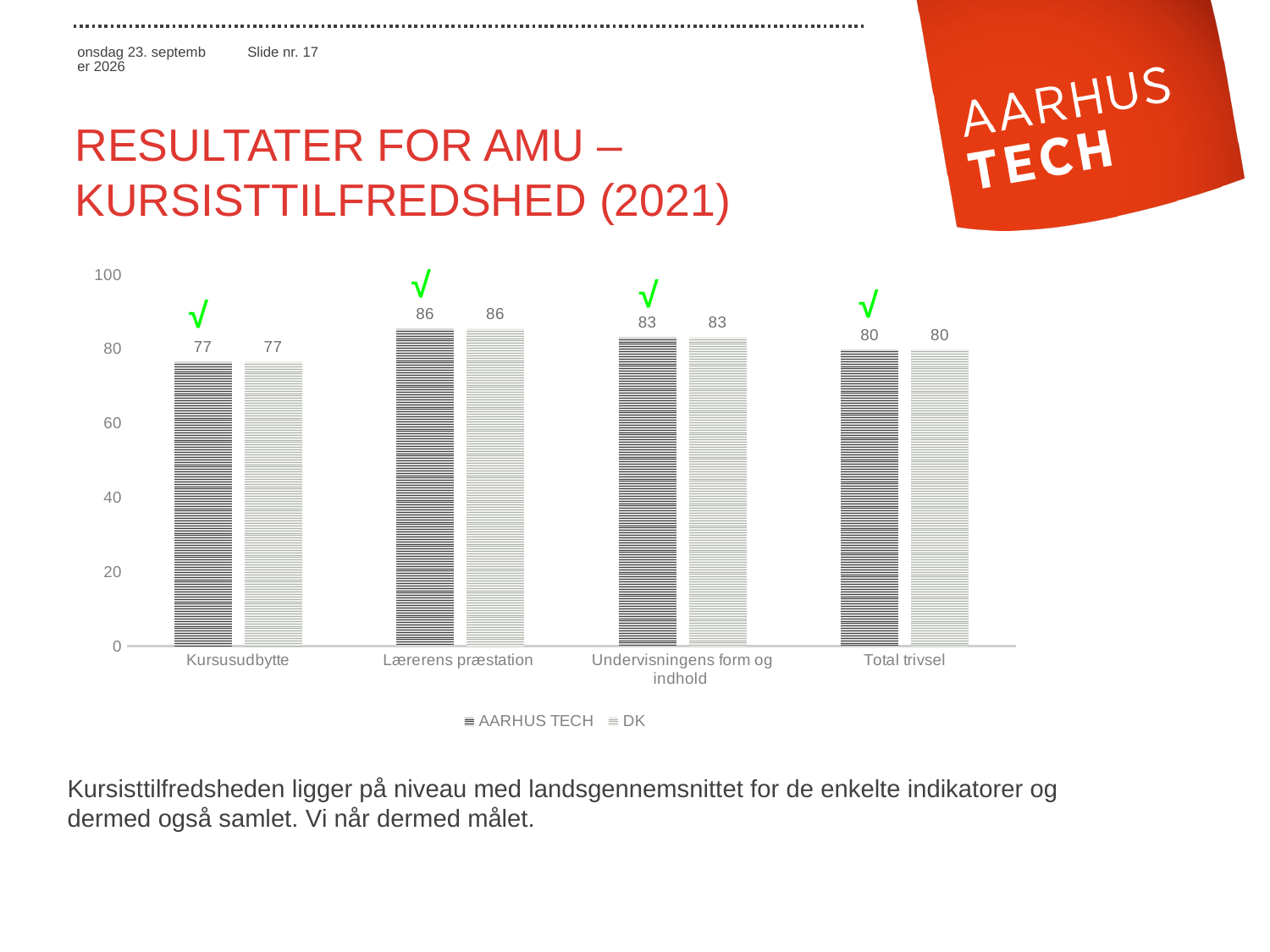
How many categories are shown on the x axis? 4 What is the AARHUS TECH value for Undervisningens form og indhold? 83 How many series does the legend list? 2 What is the DK value for Lærerens præstation? 86 What are the two series named in the legend? AARHUS TECH and DK What kind of chart is shown on the slide? Bar chart What is the difference between the AARHUS TECH values for Lærerens præstation and Kursusudbytte? 9 Which category has the highest AARHUS TECH value? Lærerens præstation Which category has the lowest DK value? Kursusudbytte What is the DK value for Total trivsel? 80 What is the AARHUS TECH value for Kursusudbytte? 77 Is the AARHUS TECH value for Kursusudbytte greater or less than 80? less